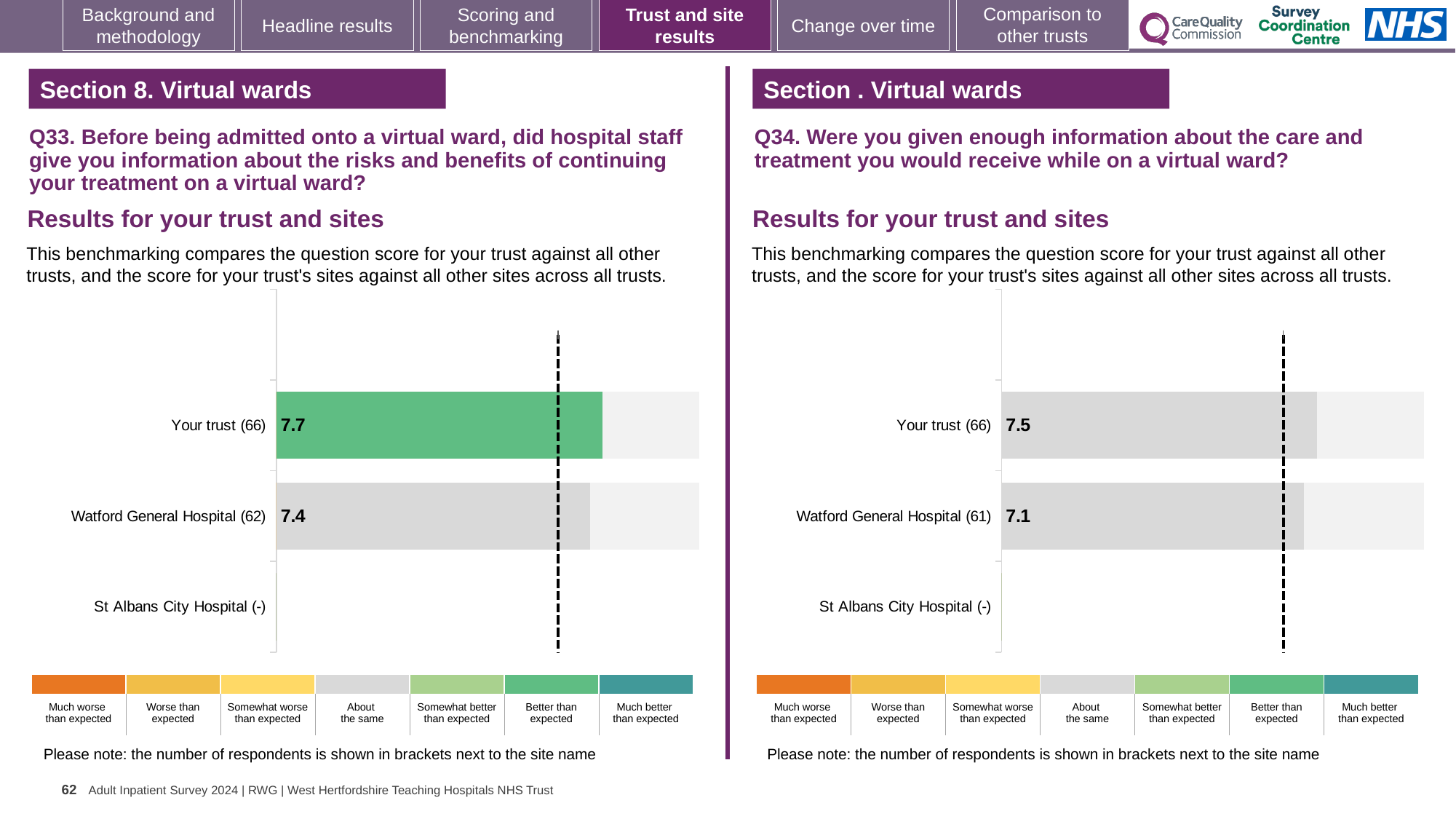
In the Q33 chart on the left, which benchmark category does the colour of the Your trust bar correspond to in the legend? Better than expected In the Q33 chart on the left, how many respondents are shown in brackets for Watford General Hospital? 62 In the Q33 chart on the left, what is the difference between the score for Your trust and the score for Watford General Hospital? 0.3 In the Q33 chart on the left, what is the score for Your trust? 7.7 In the Q33 chart on the left, what is the score for Watford General Hospital? 7.4 In the Q34 chart on the right, which has the higher score, Your trust or Watford General Hospital? Your trust In the Q34 chart on the right, what is the score for Your trust? 7.5 In the Q34 chart on the right, what is the difference between the score for Your trust and the score for Watford General Hospital? 0.4 How many site/trust categories are listed on the vertical axis of the Q33 chart on the left? 3 In the Q34 chart on the right, what is the score for Watford General Hospital? 7.1 In the Q34 chart on the right, how many respondents are shown in brackets for Watford General Hospital? 61 What kind of chart is used for the Q33 results on the left? Bar chart